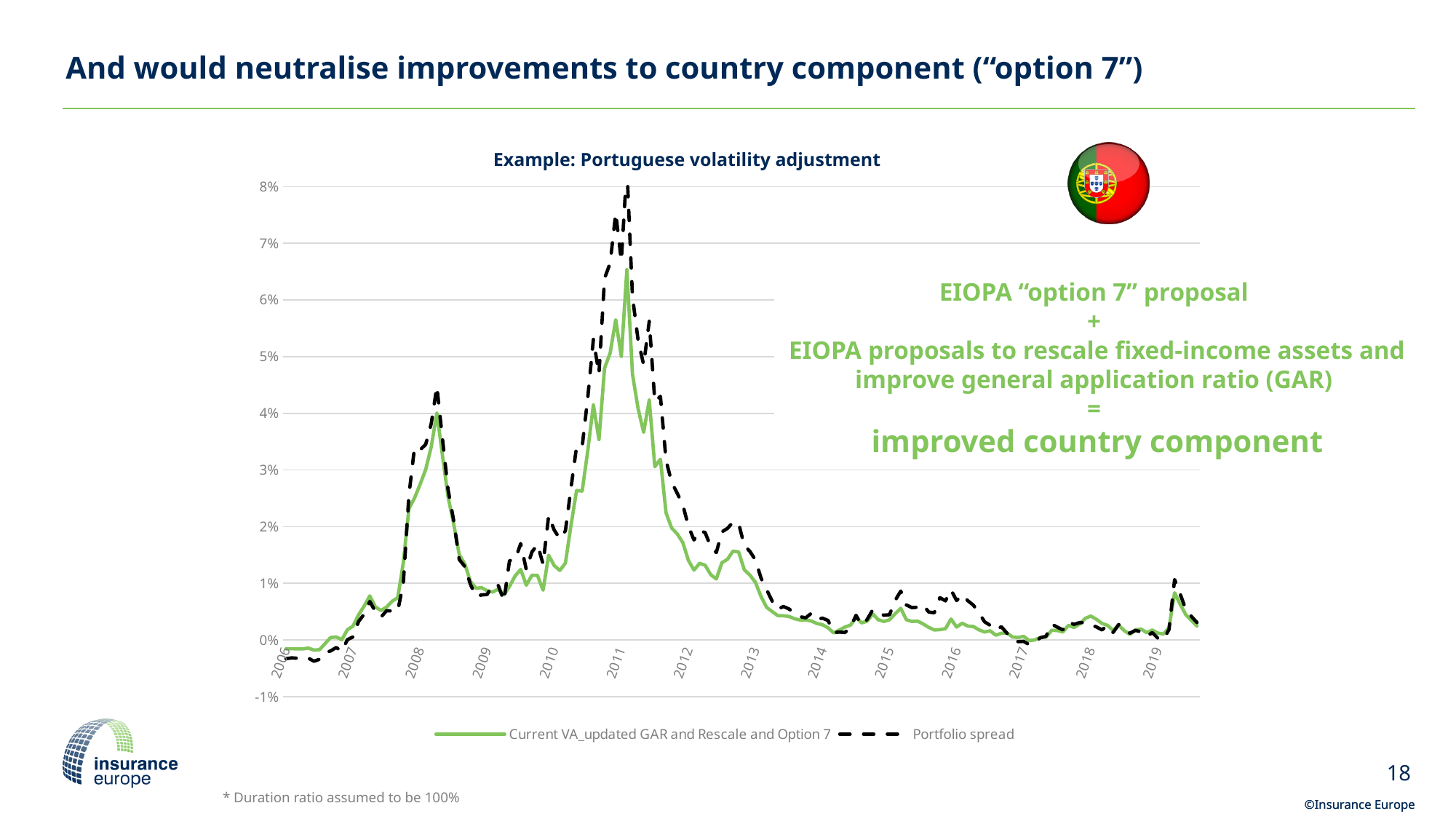
Is the peak value of the Current VA_updated GAR and Rescale and Option 7 series around 2008 greater or less than 5%? less What is the title of the chart? Example: Portuguese volatility adjustment What kind of chart is shown on the slide? line chart What is the highest value shown on the chart's y axis? 8% At the 2011 peak, which series reaches the higher value: Portfolio spread or Current VA_updated GAR and Rescale and Option 7? Portfolio spread Is the peak value of the Portfolio spread series around 2011 greater or less than 7%? greater How many series does the chart legend list? 2 Is the peak value of the Current VA_updated GAR and Rescale and Option 7 series around 2011 greater or less than 6%? greater Do the values of both series rise or fall between the 2011 peak and 2014? fall Which series is drawn as a black dashed line? Portfolio spread